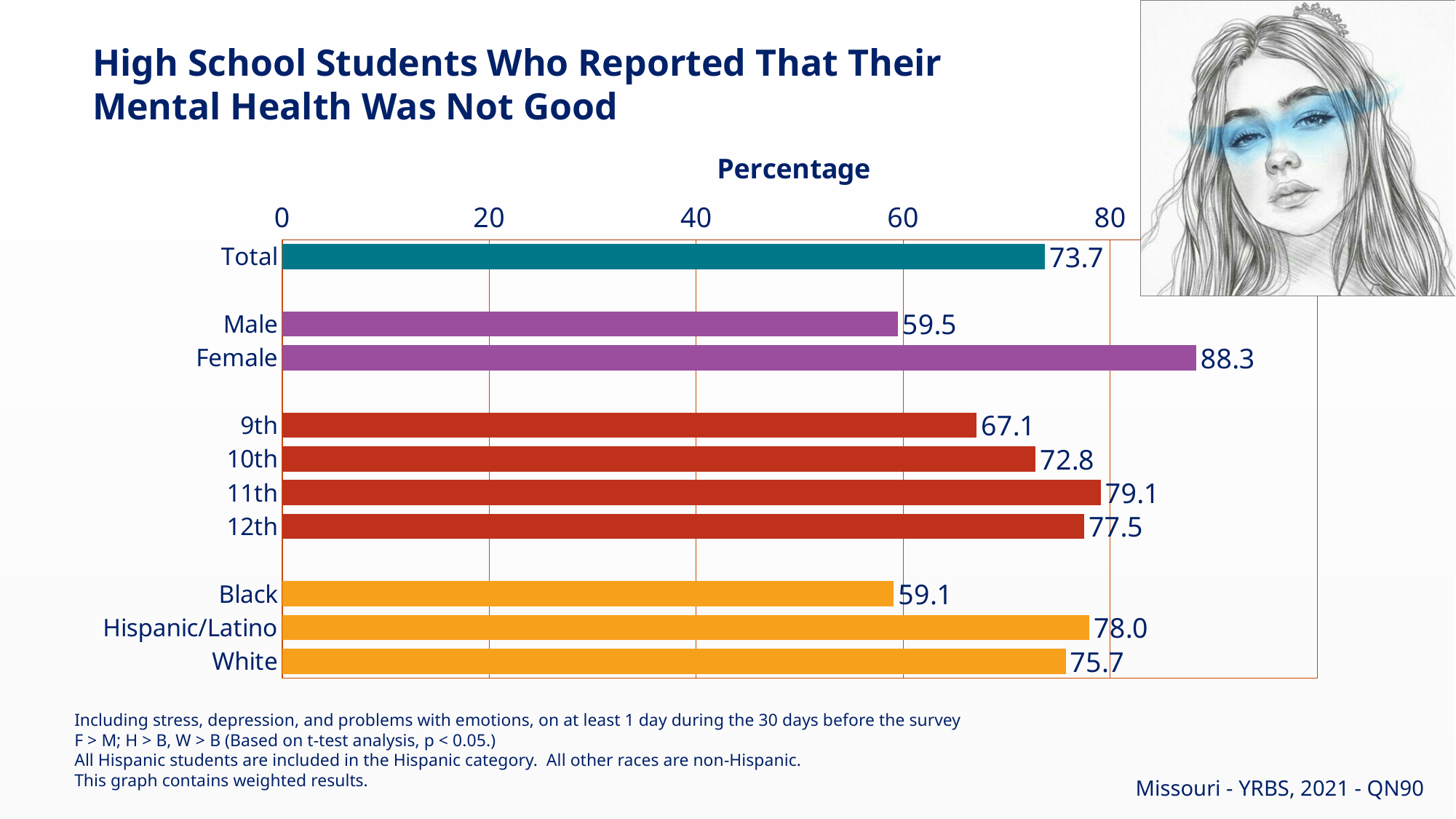
What kind of chart is shown? bar chart How many bars are plotted on the chart? 11 Which is larger, the value for 9th grade or 12th grade? 12th What is the value for the Total bar? 73.7 What is the value for 11th grade students? 79.1 Which category has the highest value? Female What is the difference between the Female and Male values? 28.8 Is the value for White greater or less than 60? greater Which category has the lowest value? Black What is the value for Hispanic/Latino students? 78.0 What is the label on the horizontal axis? Percentage What percentage is shown for Female? 88.3